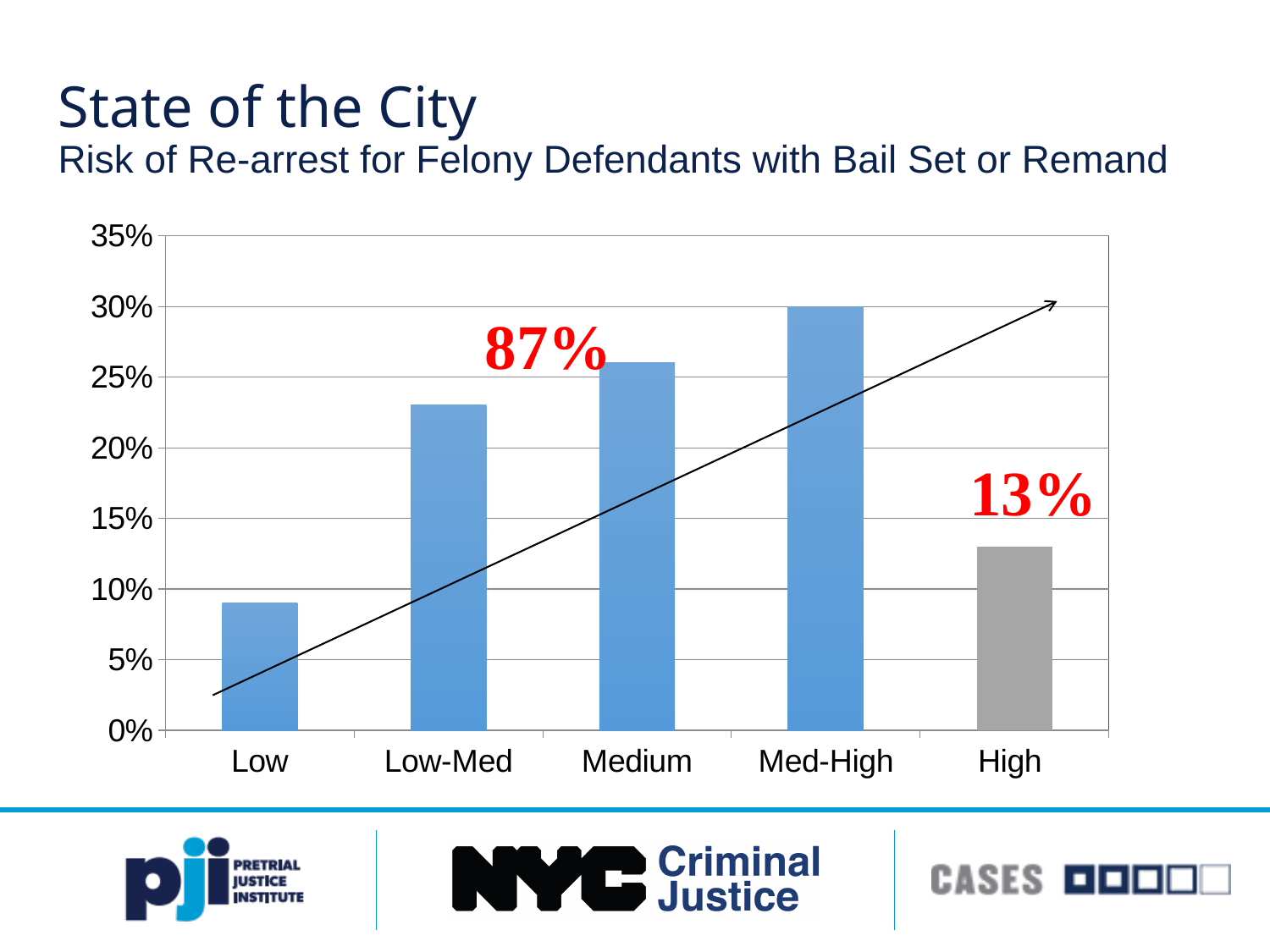
What kind of chart is shown on the slide? bar chart Which risk category has the lowest re-arrest rate? Low Do the values rise or fall from Low to Med-High along the x axis? rise What colour is the bar for the High category? gray Which risk category has the highest re-arrest rate? Med-High What is the re-arrest rate for the Med-High category? 30% How many risk categories are shown on the x axis? 5 Which has a higher re-arrest rate, High or Low? High Is the value for Low greater or less than 10%? less Which has a higher re-arrest rate, Medium or Low-Med? Medium Is the value for High greater or less than 15%? less Is the value for Low-Med greater or less than 20%? greater